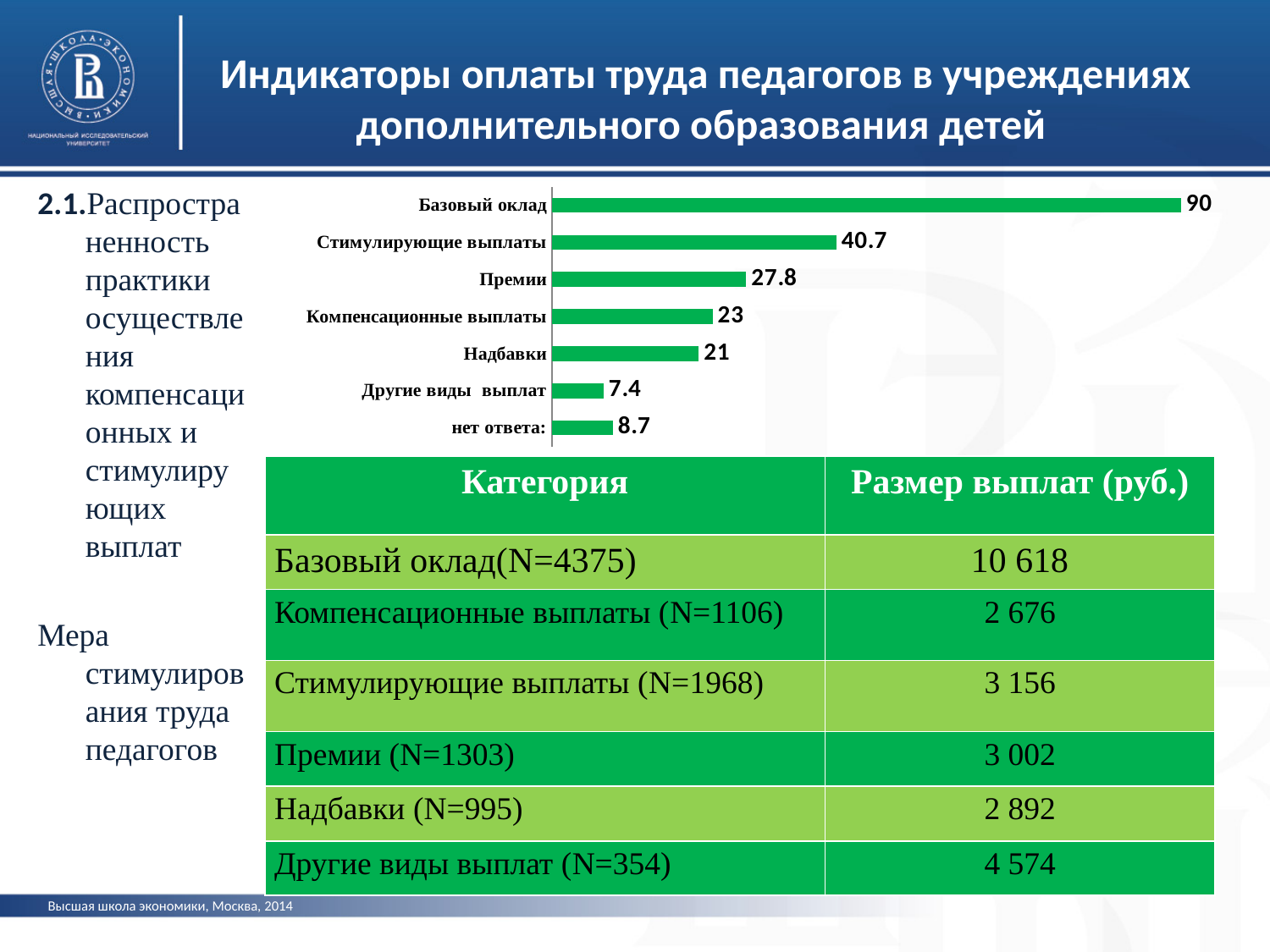
What is the difference between the values for Базовый оклад and Стимулирующие выплаты in the bar chart? 49.3 What is the value for нет ответа in the bar chart? 8.7 Which is larger in the bar chart: the value for Премии or the value for Компенсационные выплаты? Премии What type of chart is shown on the slide? Bar chart Which category has the highest value in the bar chart? Базовый оклад What is the value for Стимулирующие выплаты in the bar chart? 40.7 How many categories are shown in the bar chart? 7 What is the value for Базовый оклад in the bar chart? 90 What is the value for Надбавки in the bar chart? 21 Which category has the lowest value in the bar chart? Другие виды выплат What is the difference between the values for Компенсационные выплаты and Надбавки in the bar chart? 2 What is the value for Премии in the bar chart? 27.8